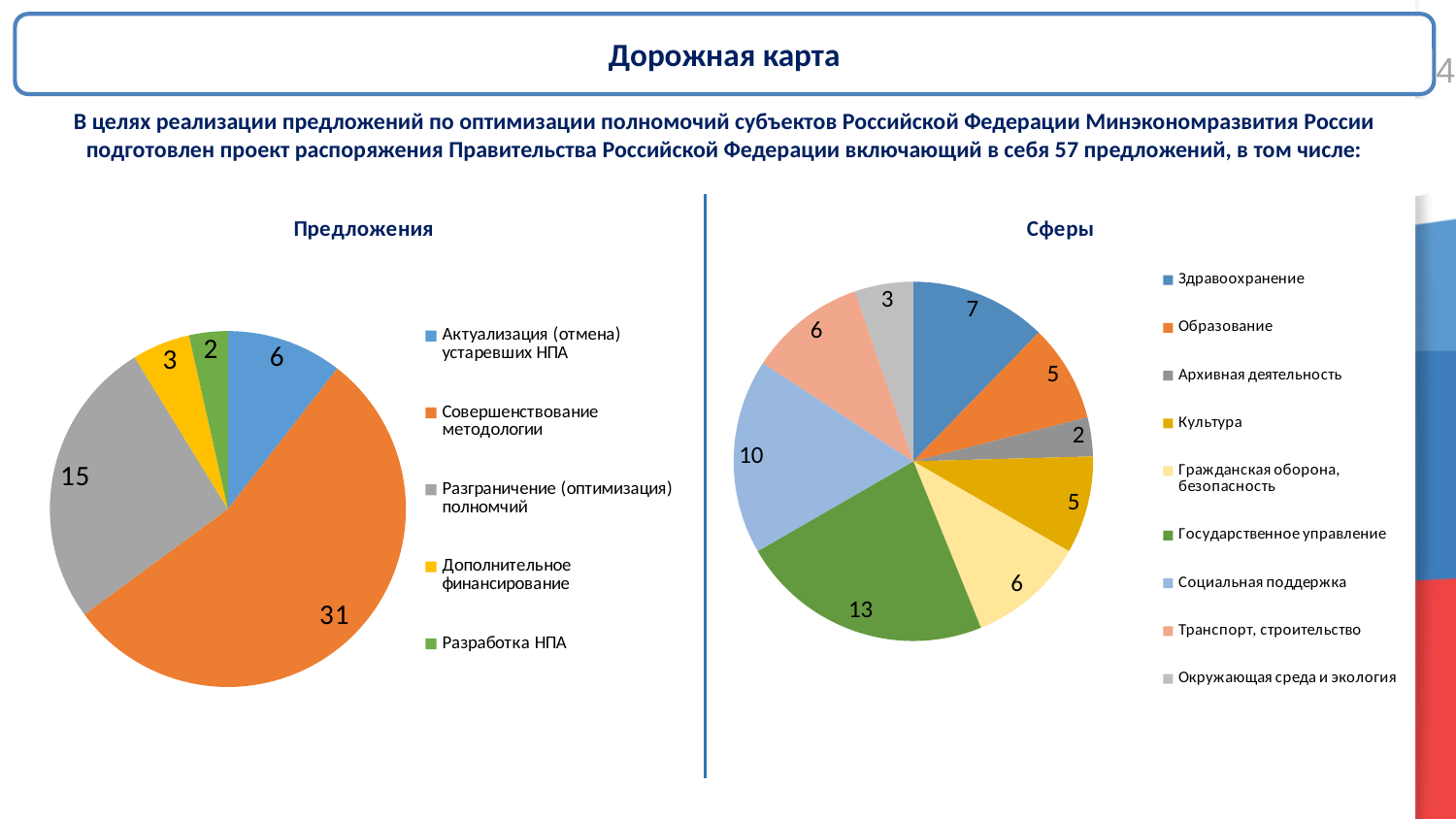
In the "Предложения" chart, what is the difference between Совершенствование методологии and Актуализация (отмена) устаревших НПА? 25 In the "Сферы" chart, how many categories does the legend list? 9 In the "Сферы" chart, what is the value for Государственное управление? 13 In the "Сферы" chart, which is larger: Здравоохранение or Архивная деятельность? Здравоохранение In the "Сферы" chart, what colour is the slice for Транспорт, строительство? Salmon (light orange) In the "Сферы" chart, which category has the largest value? Государственное управление In the "Сферы" chart, what is the value for Социальная поддержка? 10 In the "Предложения" chart, what is the value for Разграничение (оптимизация) полномочий? 15 What type of chart is the "Сферы" chart? Pie chart In the "Предложения" chart, what is the value for Совершенствование методологии? 31 In the "Предложения" chart, which category has the smallest value? Разработка НПА In the "Предложения" chart, how many categories does the legend list? 5